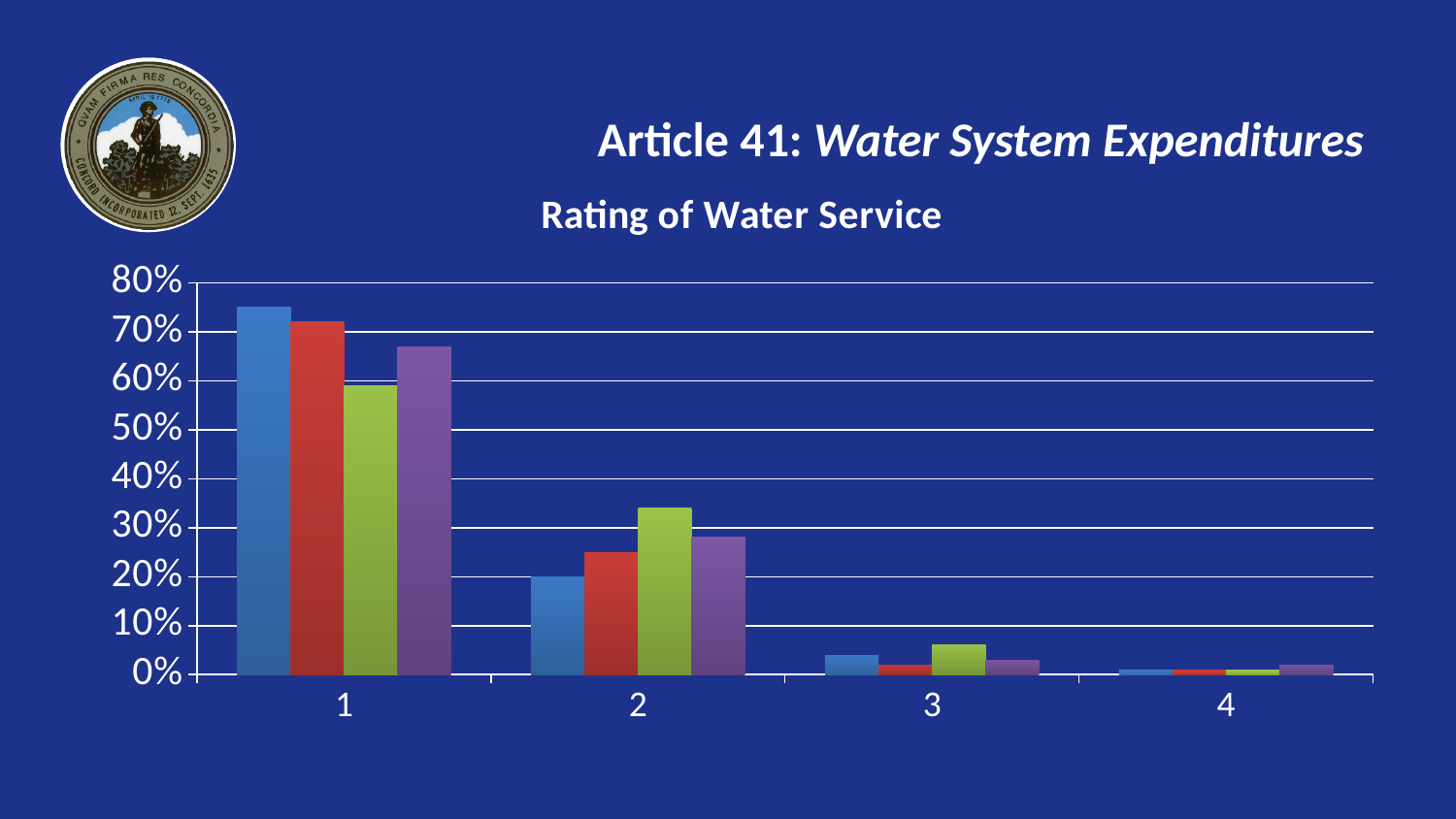
Is the value of the blue bar for category 2 greater or less than 30%? less Is the value of the green bar for category 2 greater or less than 30%? greater How many categories are shown on the x axis of the chart? 4 What kind of chart is shown on the slide? bar chart Which category has the shortest bars in the chart? 4 Is the value of the blue bar for category 1 greater or less than 70%? greater For category 1, which is larger: the blue bar or the green bar? the blue bar How many bars are plotted for each category in the chart? 4 What is the title of the chart? Rating of Water Service Do the values generally rise or fall from category 1 to category 4? fall Which category has the tallest bars in the chart? 1